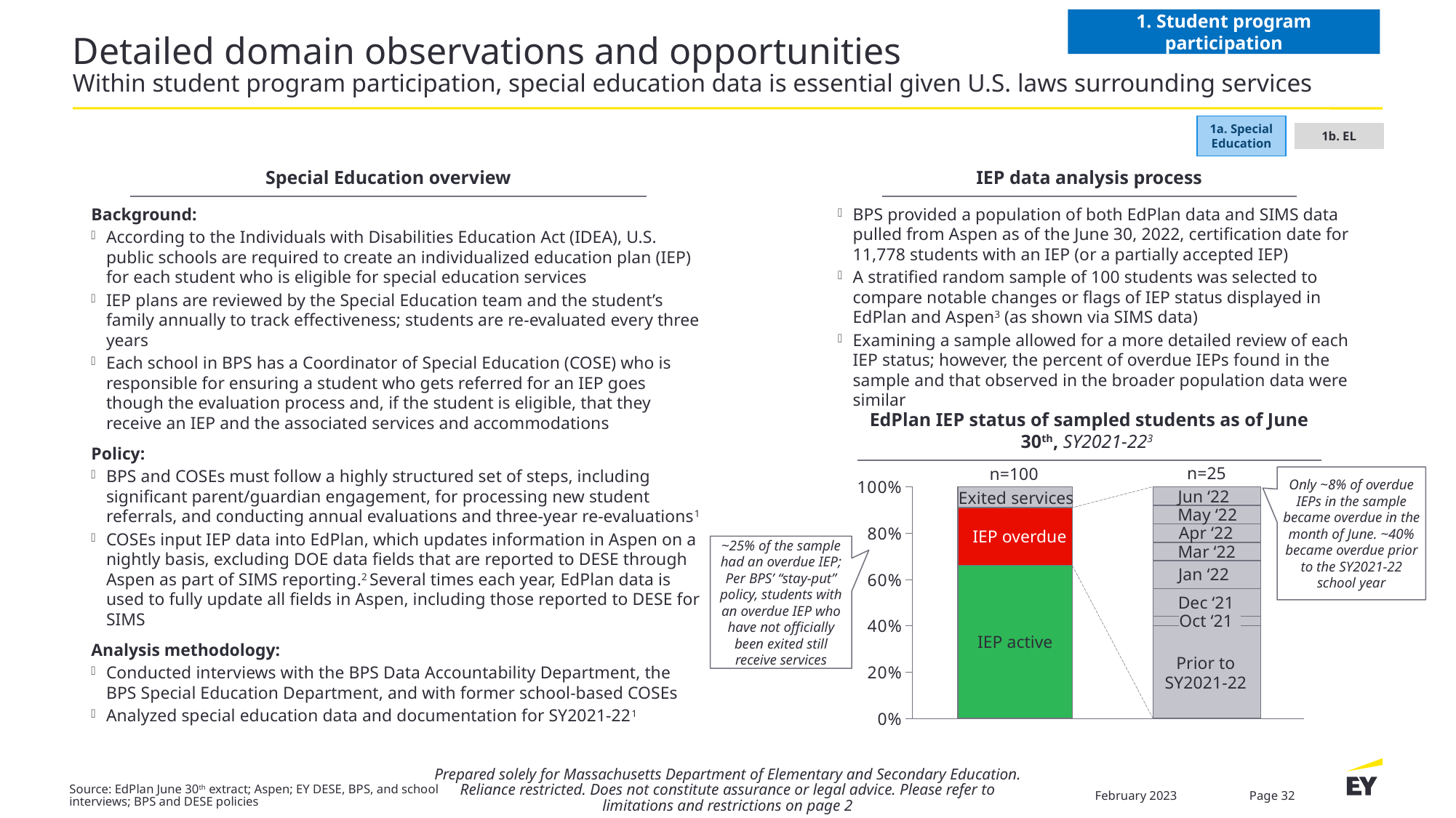
In the EdPlan IEP status chart, which segment of the n=100 bar is the smallest? Exited services How many stacked bars are plotted in the EdPlan IEP status chart? 2 In the EdPlan IEP status chart, is the share for IEP active in the n=100 bar greater or less than 60%? greater In the EdPlan IEP status chart, is the share for IEP active in the n=100 bar greater or less than 80%? less What colour is the IEP overdue segment in the EdPlan IEP status chart? Red How many segments make up the n=100 bar in the EdPlan IEP status chart? 3 In the EdPlan IEP status chart, is the share for Exited services in the n=100 bar greater or less than 20%? less In the EdPlan IEP status chart, which is larger in the n=100 bar: IEP active or IEP overdue? IEP active What sample size is labelled above the left bar in the EdPlan IEP status chart? n=100 In the EdPlan IEP status chart, which segment of the n=100 bar is the largest? IEP active What kind of chart is shown under the title 'EdPlan IEP status of sampled students as of June 30th, SY2021-22'? Stacked bar chart